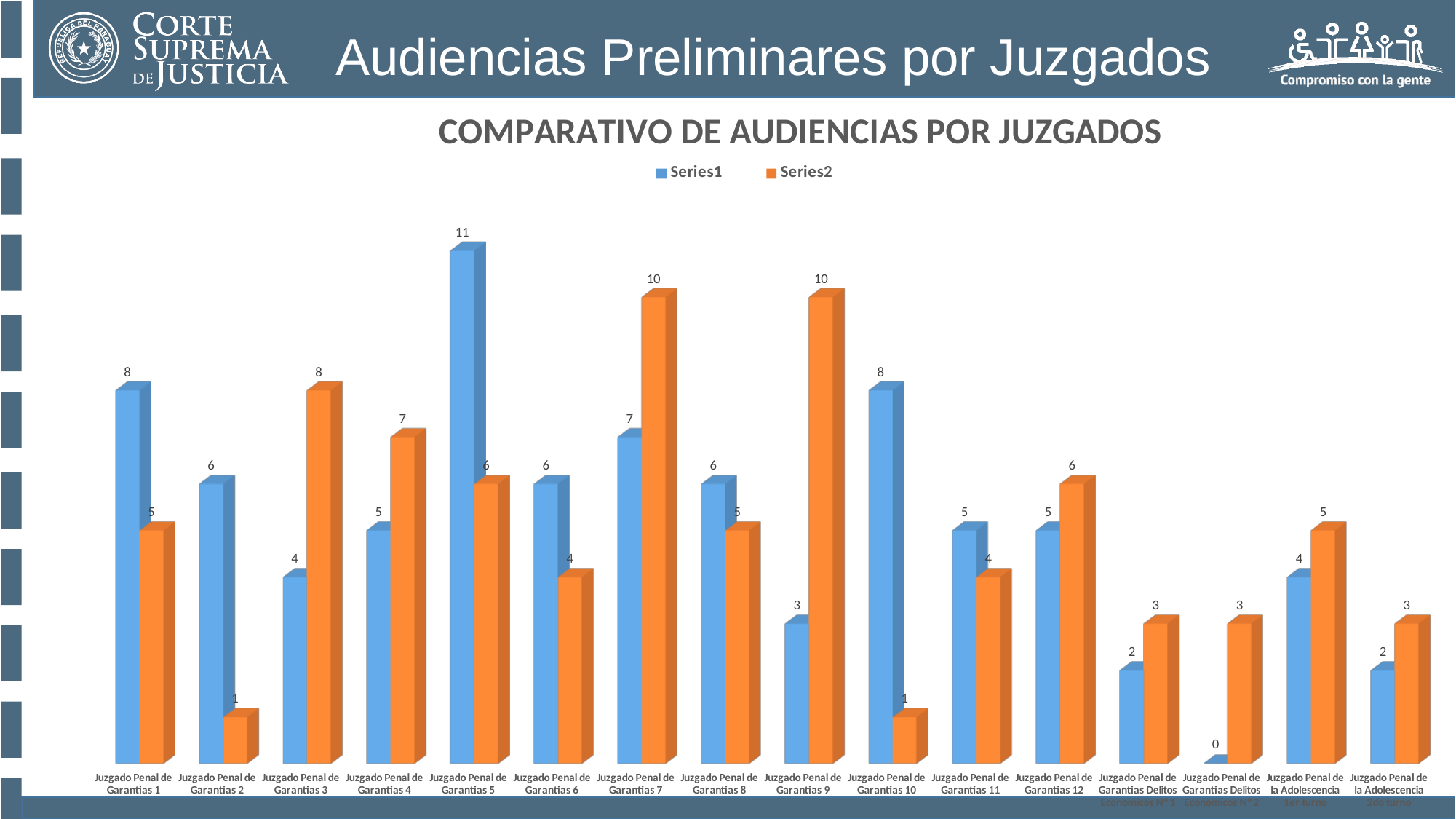
What is the difference between the Series2 and Series1 values for Juzgado Penal de Garantias 9? 7 How many series does the legend list? 2 For Juzgado Penal de Garantias 3, which series has the larger value, Series1 or Series2? Series2 What type of chart is shown on the slide? Bar chart What is the difference between the Series1 and Series2 values for Juzgado Penal de Garantias 10? 7 What is the Series2 value for Juzgado Penal de Garantias 9? 10 Which is larger: the Series1 value for Juzgado Penal de Garantias 1 or the Series1 value for Juzgado Penal de Garantias 4? Juzgado Penal de Garantias 1 What is the Series1 value for Juzgado Penal de Garantias 10? 8 What is the Series2 value for Juzgado Penal de Garantias 2? 1 Which category has the highest Series1 value? Juzgado Penal de Garantias 5 How many categories are shown on the x axis of the chart? 16 What is the Series1 value for Juzgado Penal de Garantias 5? 11